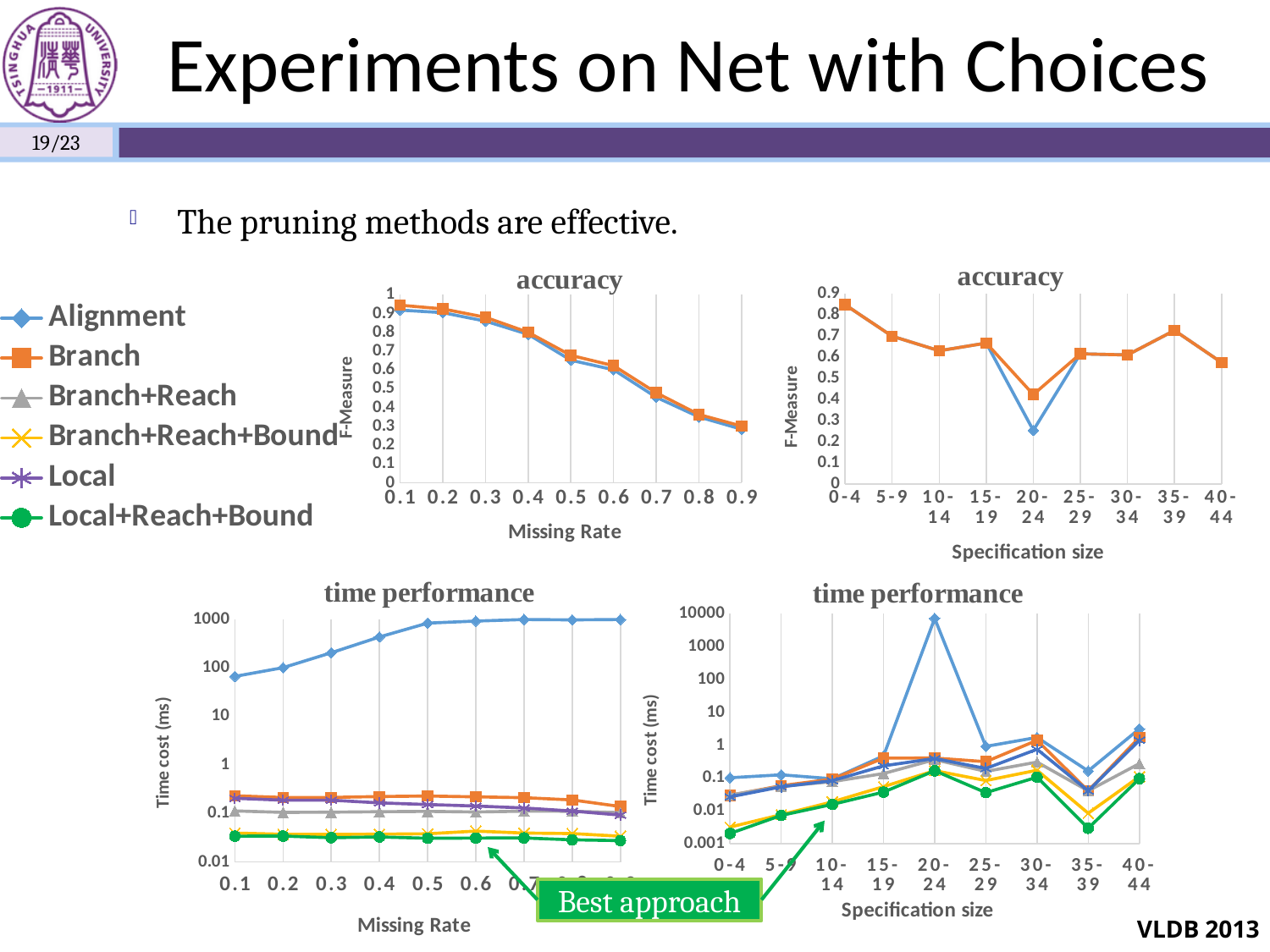
What kind of chart is the top-left 'accuracy' chart? line chart In the bottom-left 'time performance' chart, which series has the highest time cost across all Missing Rates? Alignment In the top-left 'accuracy' chart, how many Missing Rate values are plotted along the x axis? 9 In the top-right 'accuracy' chart, at which Specification size does the Alignment series have its lowest F-Measure? 20-24 In the bottom-left 'time performance' chart, does the time cost of Alignment rise or fall as the Missing Rate increases? rise In the top-right 'accuracy' chart, is the F-Measure of Alignment at Specification size 20-24 greater or less than 0.5? less In the bottom-right 'time performance' chart, is the time cost of Alignment at Specification size 20-24 greater or less than 1000? greater How many series does the shared legend on the left of the slide list? 6 In the bottom-left 'time performance' chart, is the time cost of Alignment at Missing Rate 0.1 greater or less than 10? greater In the bottom-right 'time performance' chart, at which Specification size does the Alignment series reach its peak time cost? 20-24 In the top-left 'accuracy' chart, does the F-Measure rise or fall as the Missing Rate increases? fall In the top-right 'accuracy' chart, at which Specification size is the F-Measure highest? 0-4